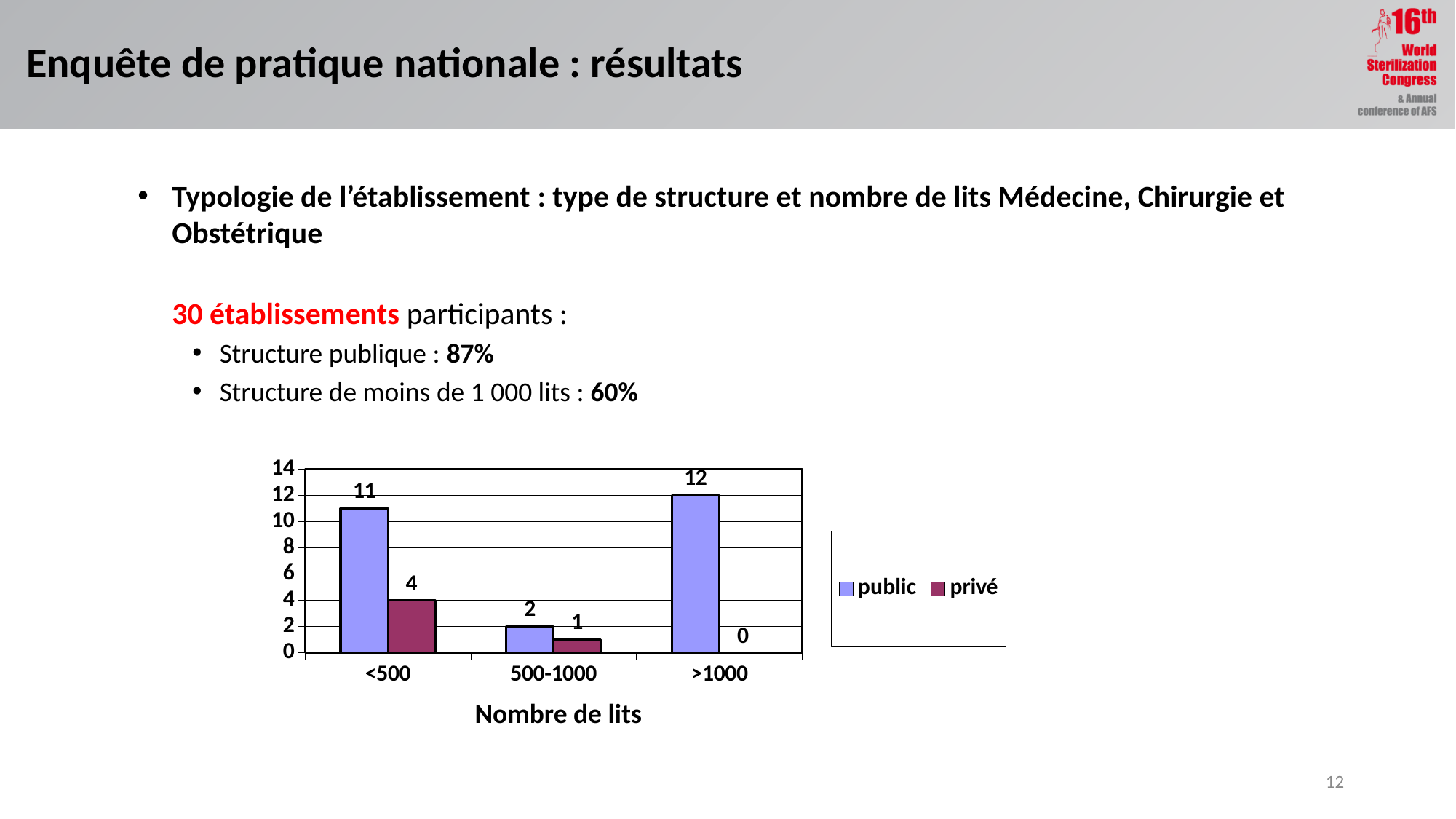
What kind of chart is shown? bar chart What is the value for public in the <500 category? 11 Which category has the highest value for public? >1000 How many series does the legend list? 2 What is the value for public in the 500-1000 category? 2 What is the value for privé in the >1000 category? 0 What is the value for privé in the <500 category? 4 How many categories are shown on the x axis? 3 Which category has the lowest value for privé? >1000 What is the x-axis title of the chart? Nombre de lits Which is larger in the 500-1000 category, public or privé? public What is the difference between public and privé in the <500 category? 7